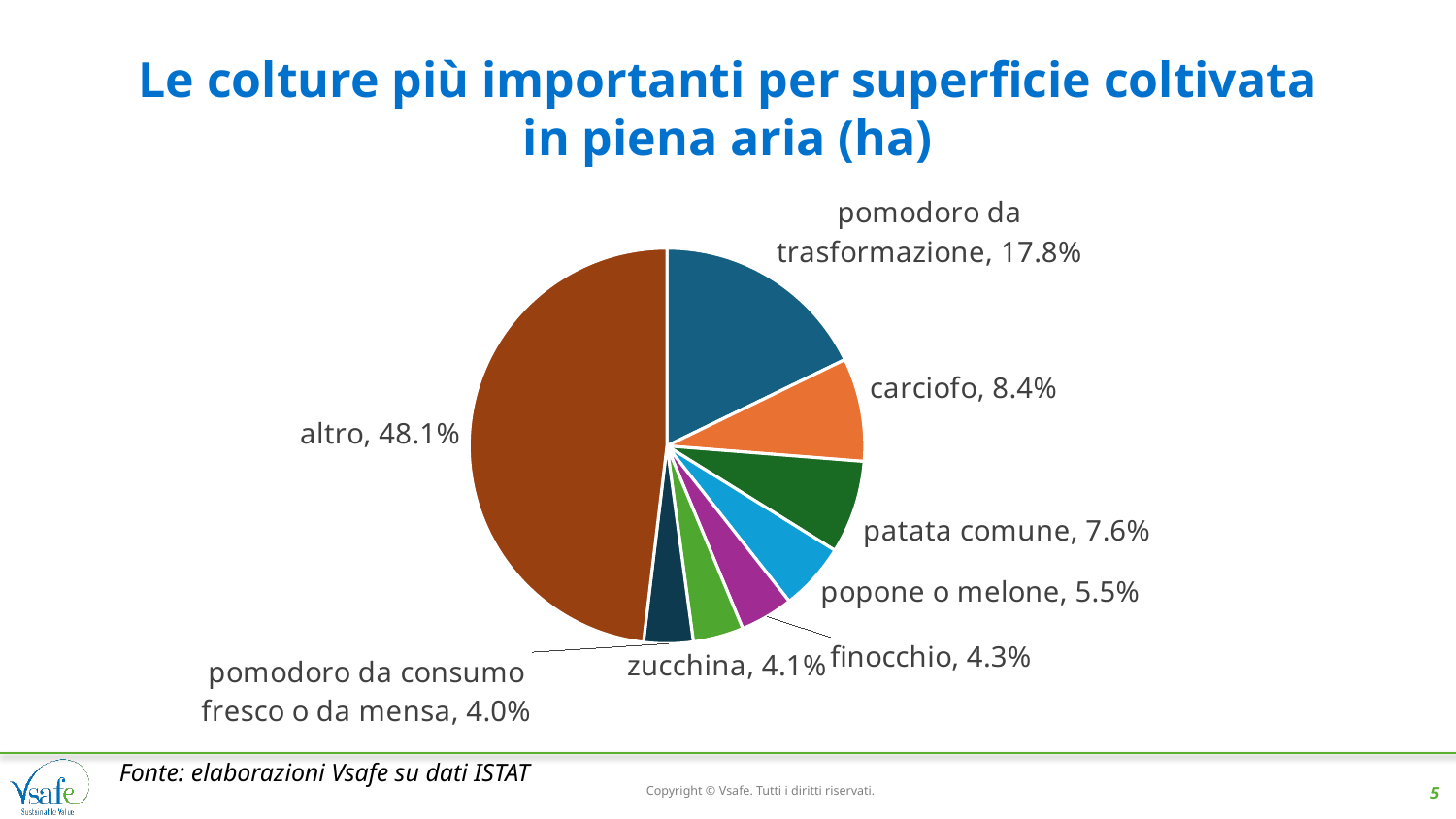
Which is larger, the share for 'finocchio' or the share for 'zucchina'? finocchio Which slice of the pie is the largest? altro What share of the pie does 'pomodoro da trasformazione' have? 17.8% What is the value shown for 'pomodoro da consumo fresco o da mensa'? 4.0% What is the value shown for 'patata comune'? 7.6% What is the value shown for 'carciofo'? 8.4% Which slice of the pie is the smallest? pomodoro da consumo fresco o da mensa What kind of chart is shown on the slide? pie chart What is the title of the chart on the slide? Le colture più importanti per superficie coltivata in piena aria (ha) What is the difference between the shares of 'carciofo' and 'patata comune'? 0.8% How many slices does the pie chart have? 8 What is the value shown for 'popone o melone'? 5.5%